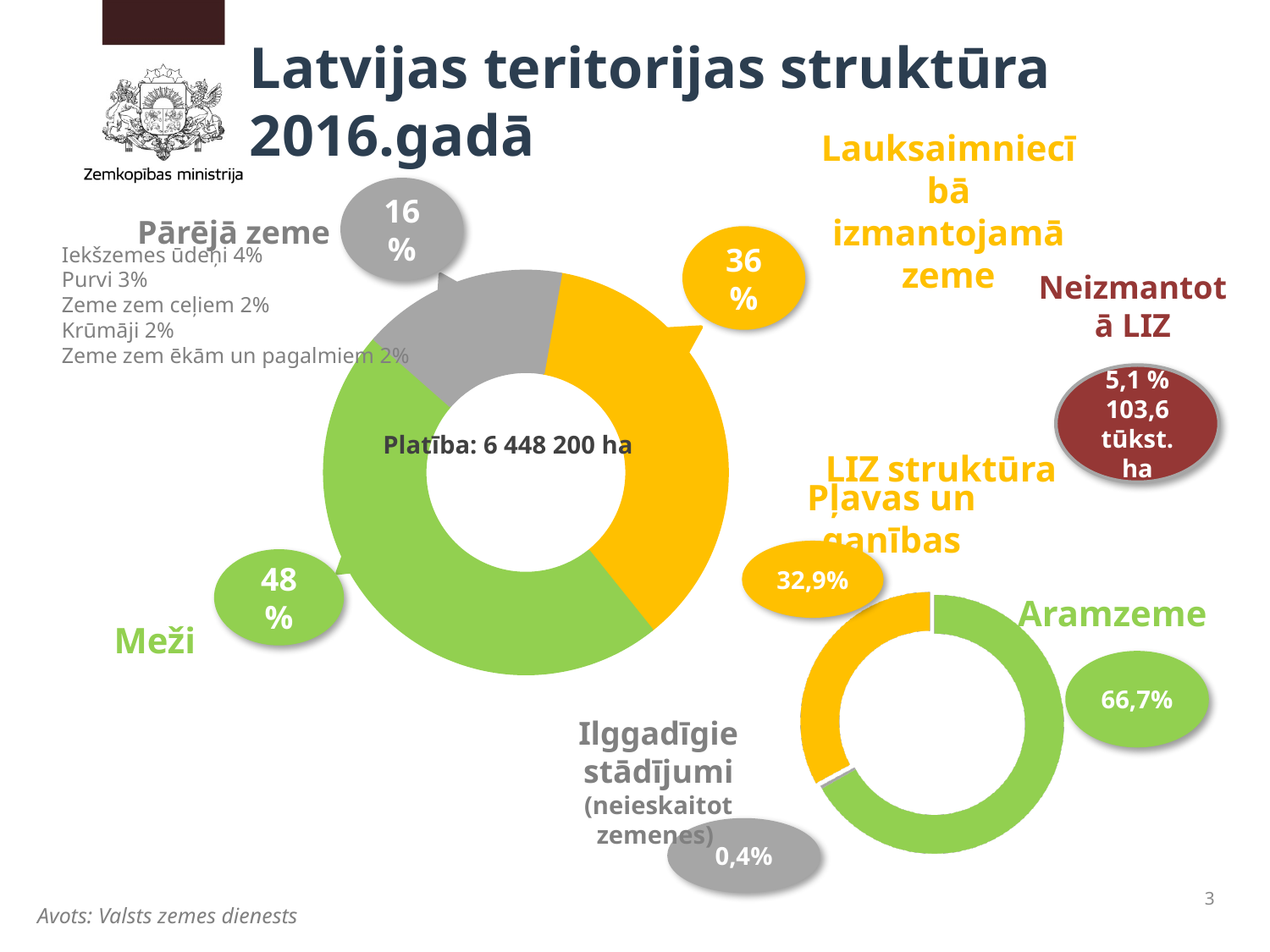
In the large doughnut chart, what is the difference in percentage points between Meži and Pārējā zeme? 32 In the LIZ struktūra chart, what share is shown for Ilggadīgie stādījumi (neieskaitot zemenes)? 0,4% In the large doughnut chart, what share is shown for Lauksaimniecībā izmantojamā zeme? 36 % In the LIZ struktūra chart, what share is shown for Aramzeme? 66,7% In the large doughnut chart, what share is shown for Meži? 48 % In the large doughnut chart, which category has the largest share? Meži In the LIZ struktūra chart, what share is shown for Pļavas un ganības? 32,9% How many categories does the LIZ struktūra chart show? 3 In the large doughnut chart, which category has the smallest share? Pārējā zeme In the LIZ struktūra chart, which is larger: Aramzeme or Pļavas un ganības? Aramzeme In the large doughnut chart, what share is shown for Pārējā zeme? 16 % What kind of chart is the large chart labelled Platība: 6 448 200 ha? Doughnut chart